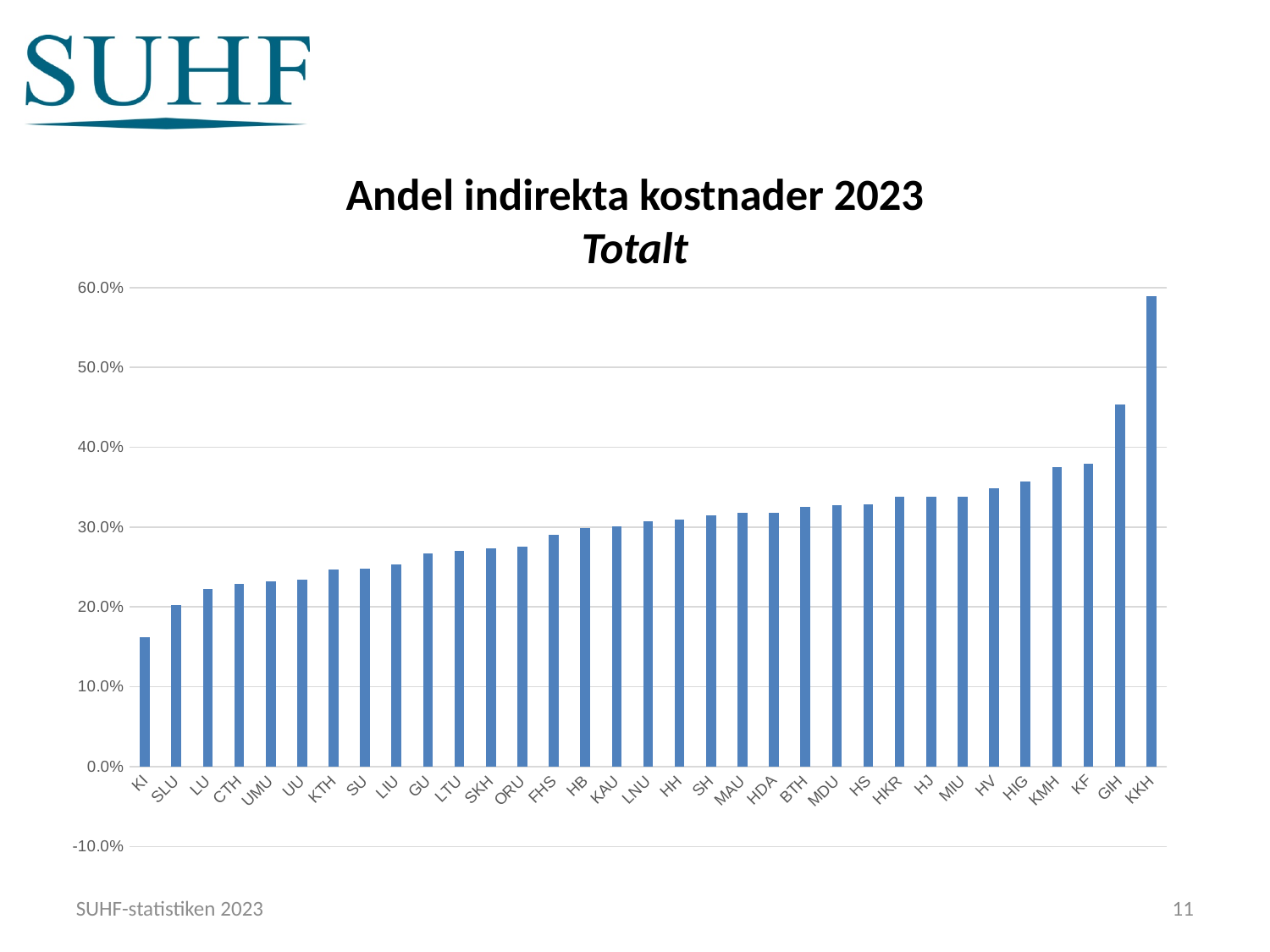
Is the value for KKH greater or less than 50.0%? greater Do the values generally rise or fall from left to right along the x axis? rise Is the value for GU greater or less than 30.0%? less Is the value for KF greater or less than 40.0%? less Which category has the lowest value? KI How many categories (bars) are shown in the chart? 33 Which category has the highest value? KKH What is the title of the chart? Andel indirekta kostnader 2023 Totalt Which has a larger value, KKH or GIH? KKH What type of chart is shown on the slide? bar chart